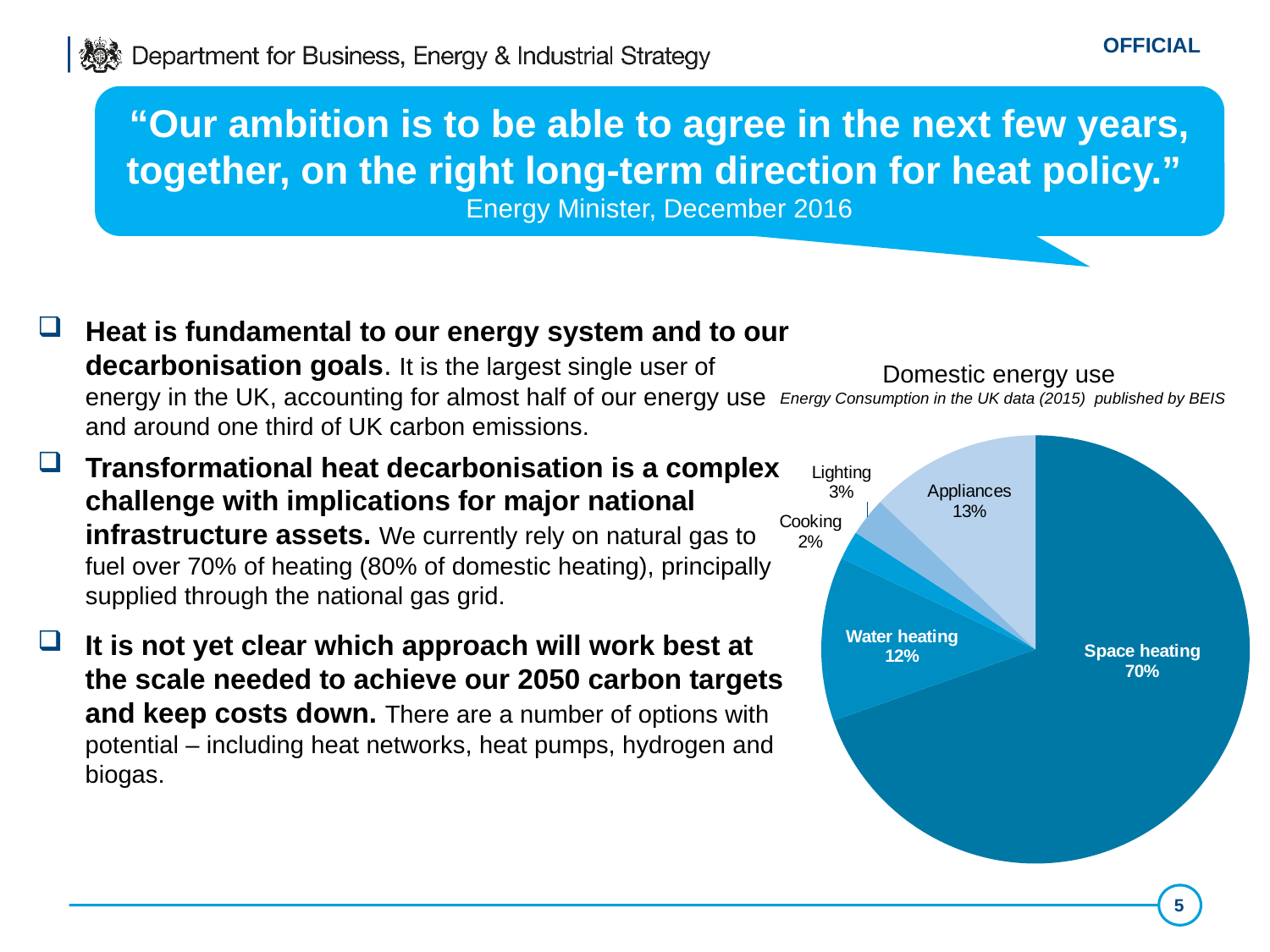
What share of domestic energy use is Cooking? 2% How many categories are shown in the pie chart? 5 Which category has the smallest share of domestic energy use? Cooking What share of domestic energy use is Space heating? 70% What share of domestic energy use is Lighting? 3% Which is larger, the share for Appliances or the share for Water heating? Appliances What is the difference in percentage points between Space heating and Water heating? 58 What share of domestic energy use is Appliances? 13% What is the title of the chart? Domestic energy use What kind of chart is shown on the slide? Pie chart What share of domestic energy use is Water heating? 12% Which category has the largest share of domestic energy use? Space heating